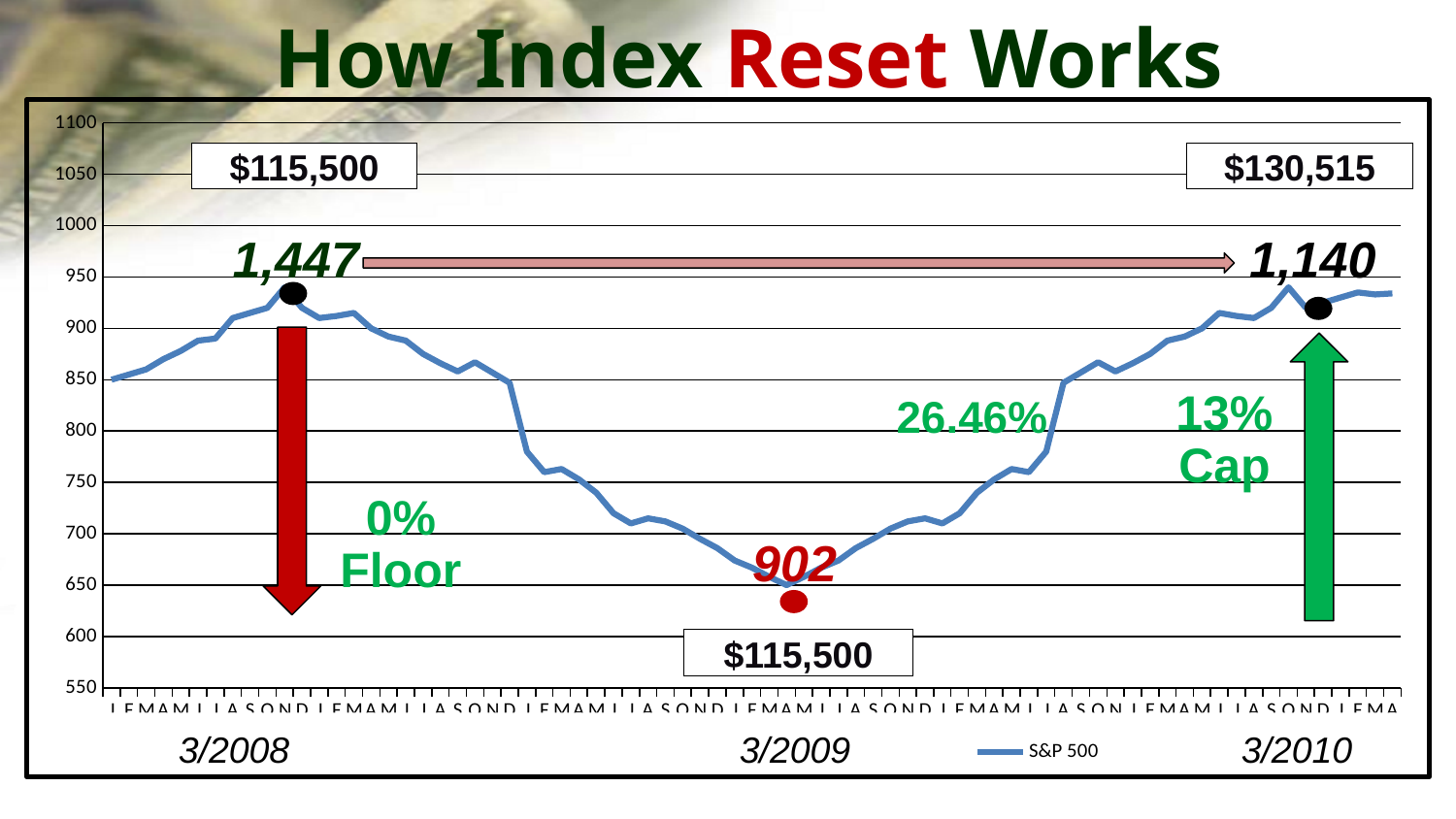
What is the difference between the labeled index values at 3/2008 and 3/2009? 545 What index value is labeled at 3/2009? 902 What index value is labeled at 3/2008? 1,447 How many series does the legend list? 1 Which of the three labeled dates (3/2008, 3/2009, 3/2010) has the highest labeled index value? 3/2008 Which of the three labeled dates (3/2008, 3/2009, 3/2010) has the lowest labeled index value? 3/2009 What series name appears in the legend? S&P 500 Does the S&P 500 line rise or fall between 3/2009 and 3/2010? rise What is the title of the slide? How Index Reset Works Is the labeled index value at 3/2010 larger or smaller than the labeled value at 3/2008? smaller What kind of chart is shown on the slide? line chart What index value is labeled at 3/2010? 1,140